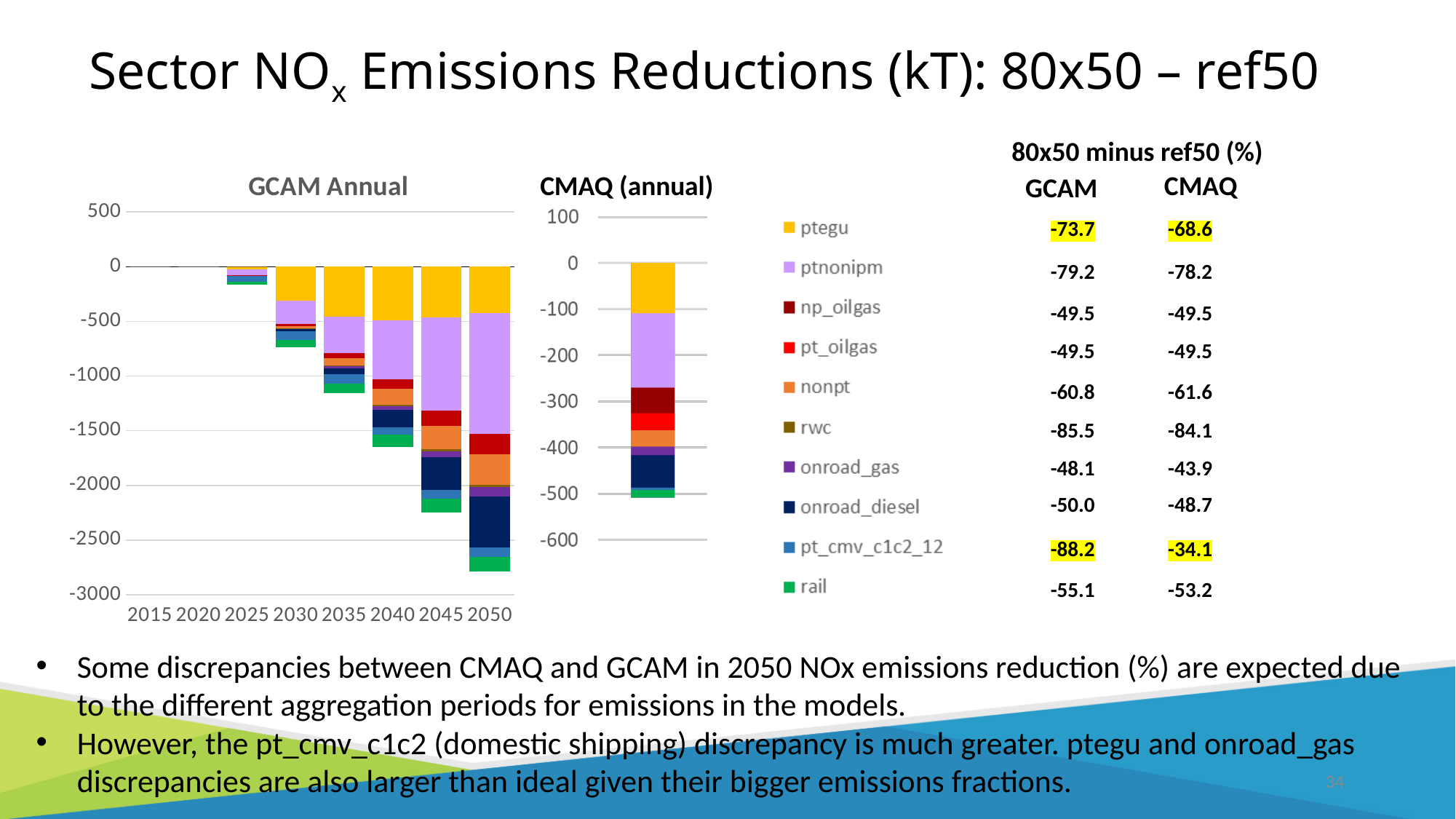
Which series is listed first in the legend? ptegu What kind of chart is the GCAM Annual chart? stacked bar chart How many year labels are shown on the x axis of the GCAM Annual chart? 8 How many series does the legend list for the charts? 10 In the GCAM Annual chart, is the total value for 2050 greater or less than -2500? less In the GCAM Annual chart, is the total value for 2030 greater or less than -1000? greater In the GCAM Annual chart, which year has the largest total emissions reduction (most negative stacked bar)? 2050 In the CMAQ (annual) chart, is the total value of the stacked bar greater or less than -400? less In the GCAM Annual chart, do the stacked bars become more negative or less negative from 2025 to 2050? more negative In the GCAM Annual chart, which year with a visible bar has the smallest total emissions reduction? 2025